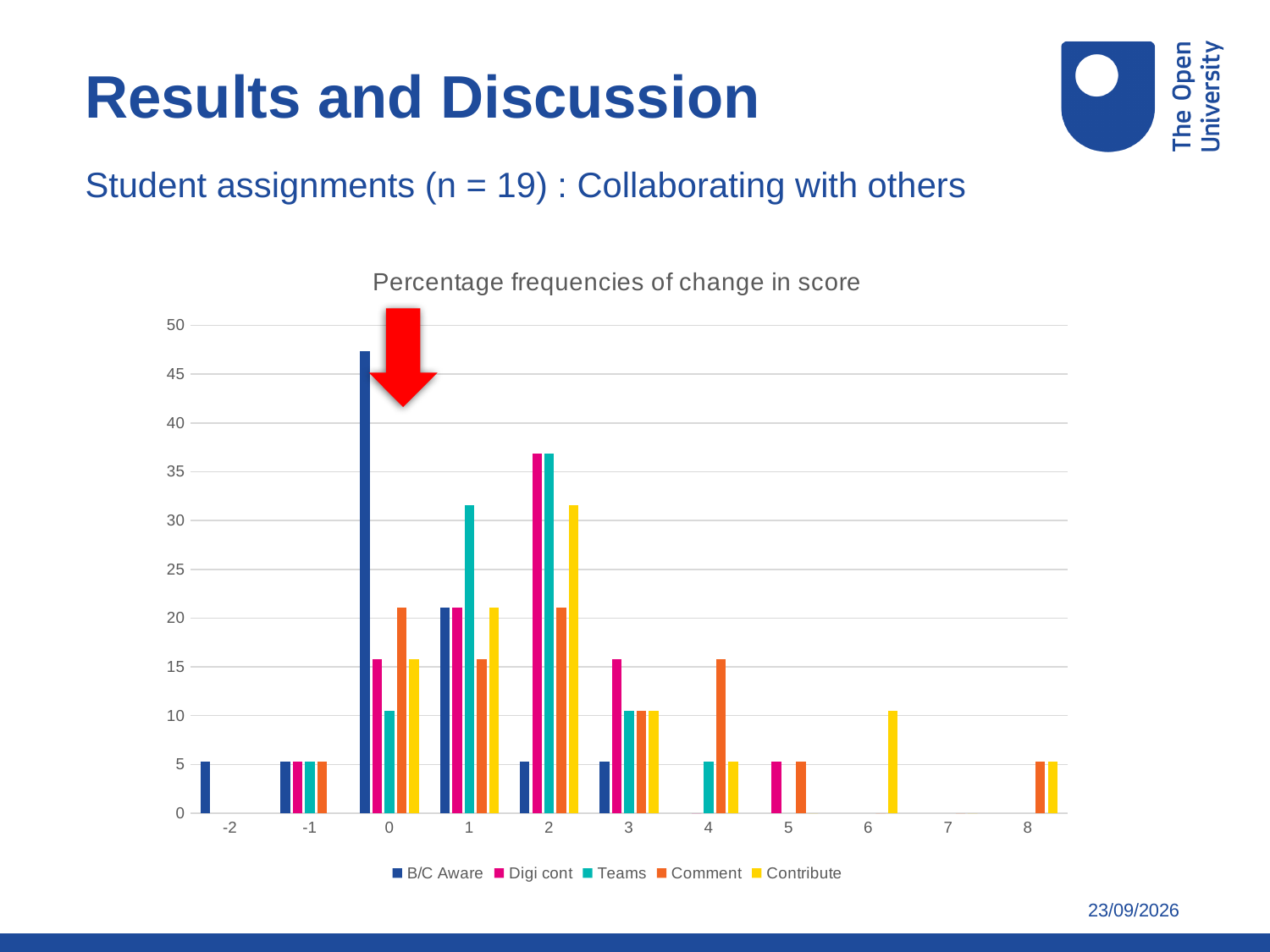
How many categories are shown along the x axis? 11 Which series has the tallest bar at change in score 4? Comment Is the value for Digi cont at change in score 2 greater or less than 30? greater Which series is the only one with a bar at change in score -2? B/C Aware How many series does the legend list? 5 Is the value for Contribute at change in score 6 greater or less than 15? less At change in score 3, which is larger, the Digi cont bar or the B/C Aware bar? Digi cont What kind of chart is shown on the slide? bar chart What is the title of the chart? Percentage frequencies of change in score Which series has the tallest bar at change in score 0? B/C Aware Is the value for B/C Aware at change in score 0 greater or less than 40? greater At change in score 1, which is larger, the Teams bar or the Comment bar? Teams